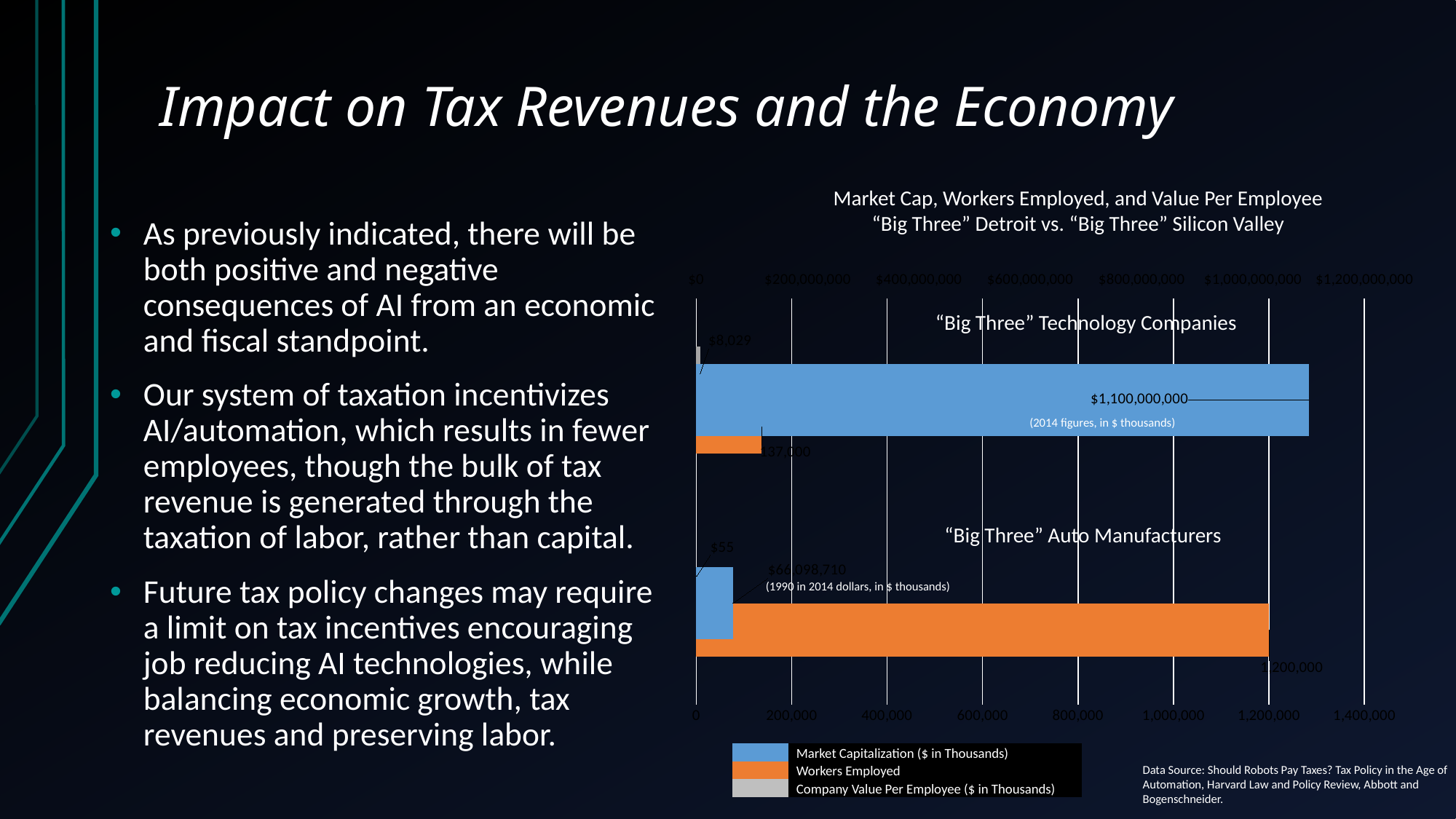
How many company groups (categories) are plotted in the chart? 2 How many Workers Employed are shown for the "Big Three" Auto Manufacturers? 1,200,000 Which group has the higher Market Capitalization, the Technology Companies or the Auto Manufacturers? "Big Three" Technology Companies What colour represents the Workers Employed series in the chart? orange How many series does the chart legend list? 3 What is the difference in Company Value Per Employee between the Technology Companies and the Auto Manufacturers? $7,974 What is the Market Capitalization value shown for the "Big Three" Technology Companies? $1,100,000,000 What kind of chart is shown on the slide? bar chart What is the Company Value Per Employee shown for the "Big Three" Auto Manufacturers? $55 What is the Company Value Per Employee shown for the "Big Three" Technology Companies? $8,029 Which group employs more workers, the Technology Companies or the Auto Manufacturers? "Big Three" Auto Manufacturers Is the Workers Employed value for the "Big Three" Technology Companies greater or less than 200,000? less